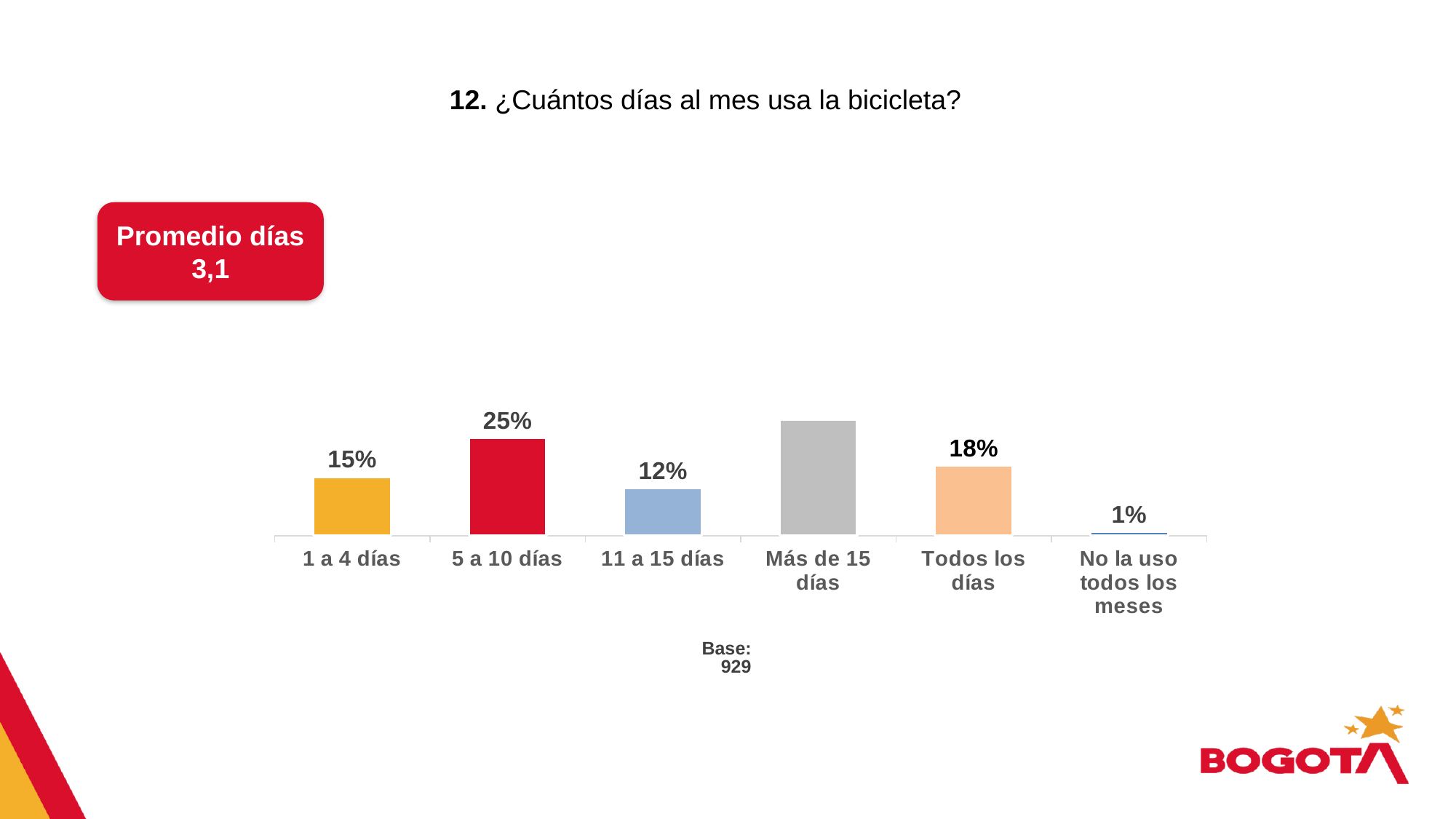
What percentage is shown for 'Todos los días'? 18% What is the difference between the values for '5 a 10 días' and '11 a 15 días'? 13% How many categories are shown on the x axis of the chart? 6 Which is larger, the value for 'Todos los días' or the value for '1 a 4 días'? Todos los días What is the average number of days shown in the red box on the slide? 3,1 What percentage of respondents use the bicycle 5 a 10 días per month? 25% Which category has the tallest bar in the chart? Más de 15 días What kind of chart is shown on the slide? Bar chart Which category has the lowest value in the chart? No la uso todos los meses What is the base (number of respondents) shown below the chart? 929 What is the value for 'No la uso todos los meses'? 1% What is the value shown for the category '1 a 4 días'? 15%